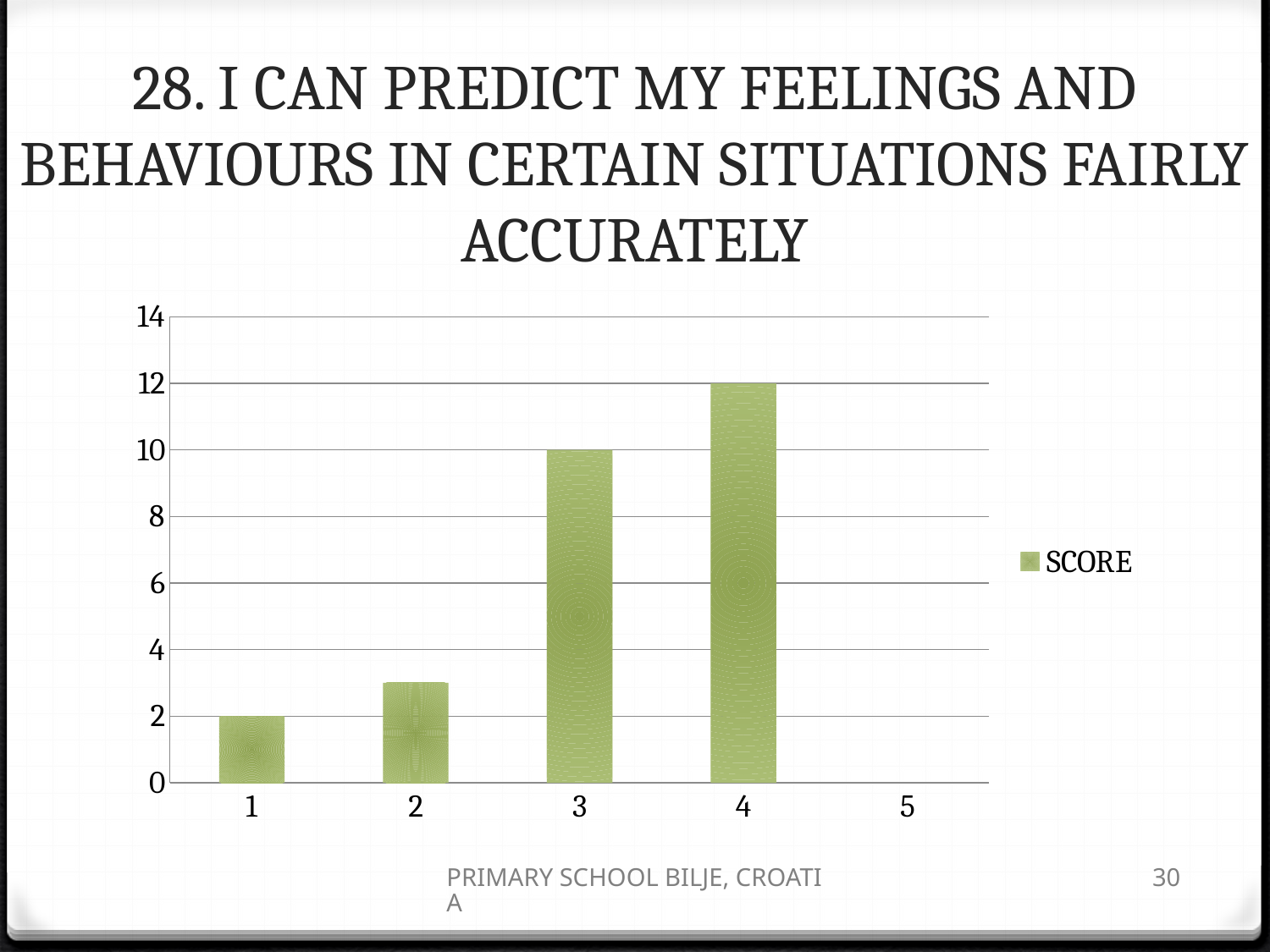
Which is larger, the value for category 3 or category 4? 4 What is the value for category 3? 10 What is the difference between the values for category 3 and category 1? 8 What is the value for category 1? 2 Which category has the tallest bar? 4 Is the value for category 2 greater or less than 4? less What is the name of the series listed in the legend? SCORE Which category has the shortest bar among those with a visible bar? 1 What is the value for category 4? 12 How many categories are shown on the x axis? 5 What type of chart is shown on the slide? Bar chart What is the difference between the values for category 4 and category 3? 2